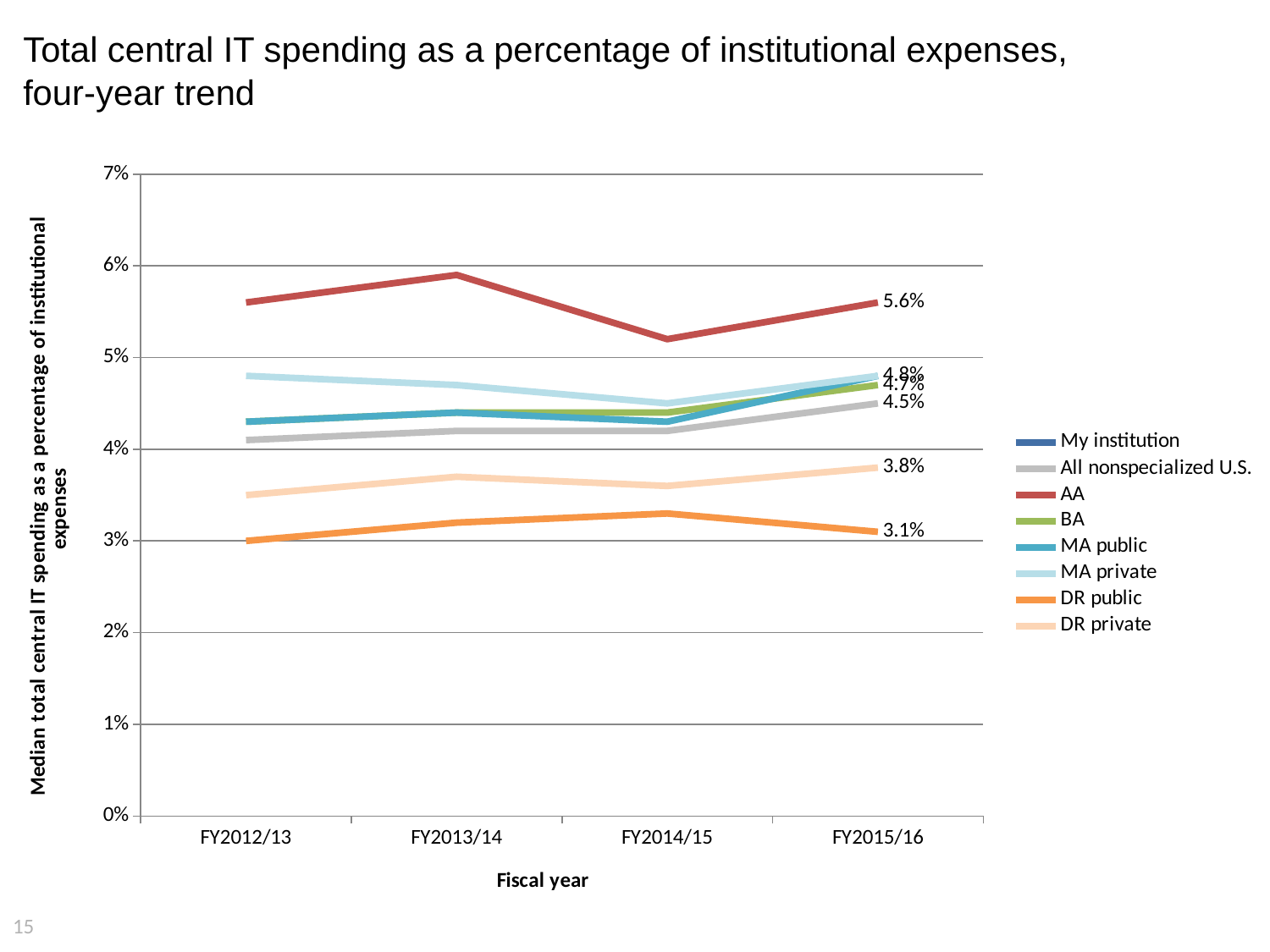
What is the difference between the AA and DR public values in FY2015/16? 2.5 percentage points How many series does the legend list? 8 What is the value for AA in FY2015/16? 5.6% Which series has the highest value in FY2015/16? AA How many fiscal years are shown on the x axis? 4 What is the value for DR public in FY2015/16? 3.1% What is the title of the x axis? Fiscal year What kind of chart is shown on the slide? Line chart Is the value for AA in FY2013/14 greater or less than 5%? greater Which series has the lowest value in FY2015/16? DR public What is the value for DR private in FY2015/16? 3.8% What is the value for All nonspecialized U.S. in FY2015/16? 4.5%